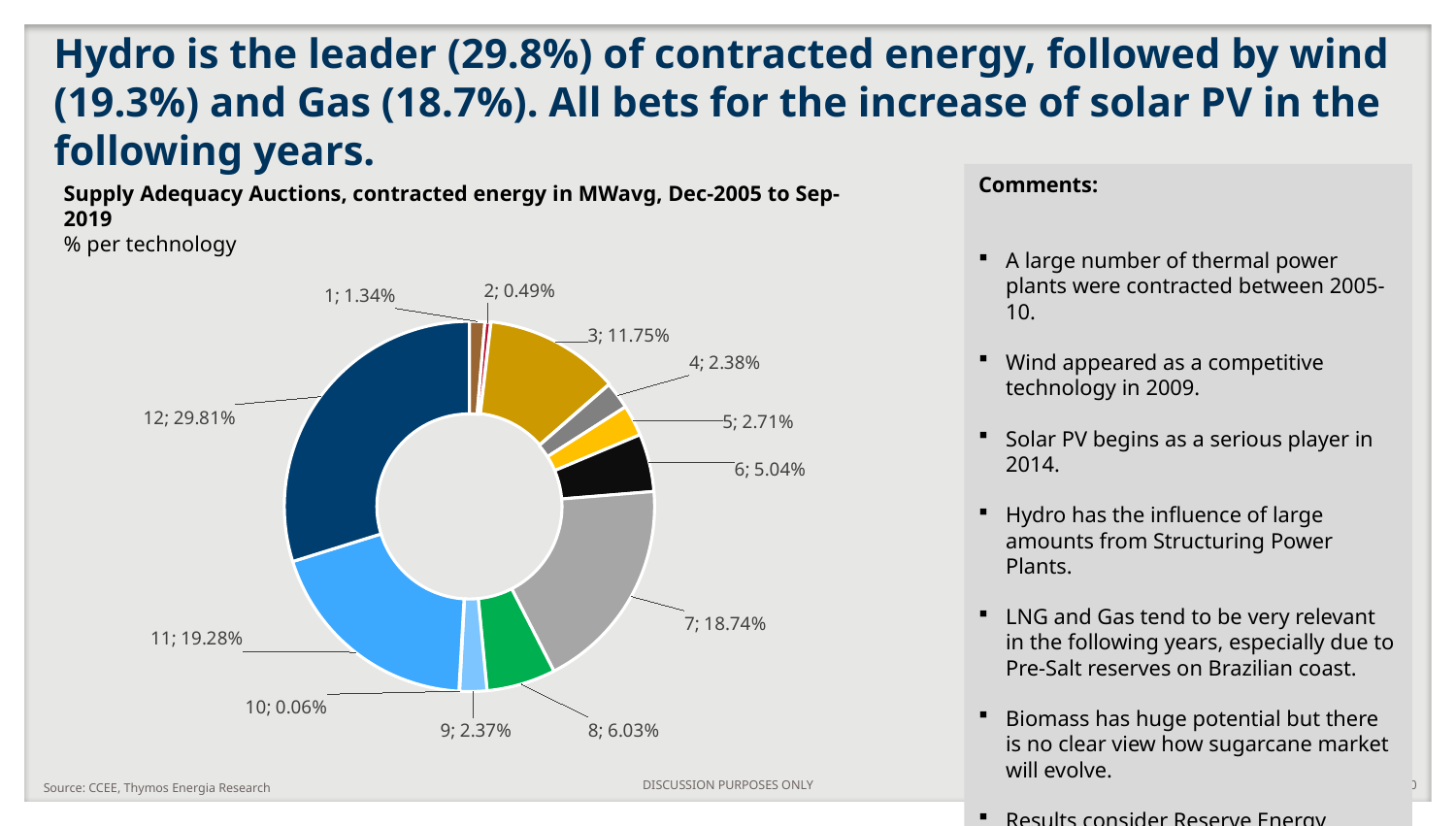
How many slices does the doughnut chart have? 12 What type of chart is shown on the slide? Doughnut (pie) chart Which category has the smallest share in the doughnut chart? 10 What is the combined share of categories 11 and 7? 38.02% What percentage is shown for category 10 in the doughnut chart? 0.06% Which category has the largest share in the doughnut chart? 12 What percentage is shown for category 12 in the doughnut chart? 29.81% What is the difference in percentage points between category 12 and category 11? 10.53 What unit of contracted energy is named in the chart title? MWavg What percentage is shown for category 7 in the doughnut chart? 18.74% What percentage is shown for category 3 in the doughnut chart? 11.75% Which has a larger share, category 8 or category 6? 8